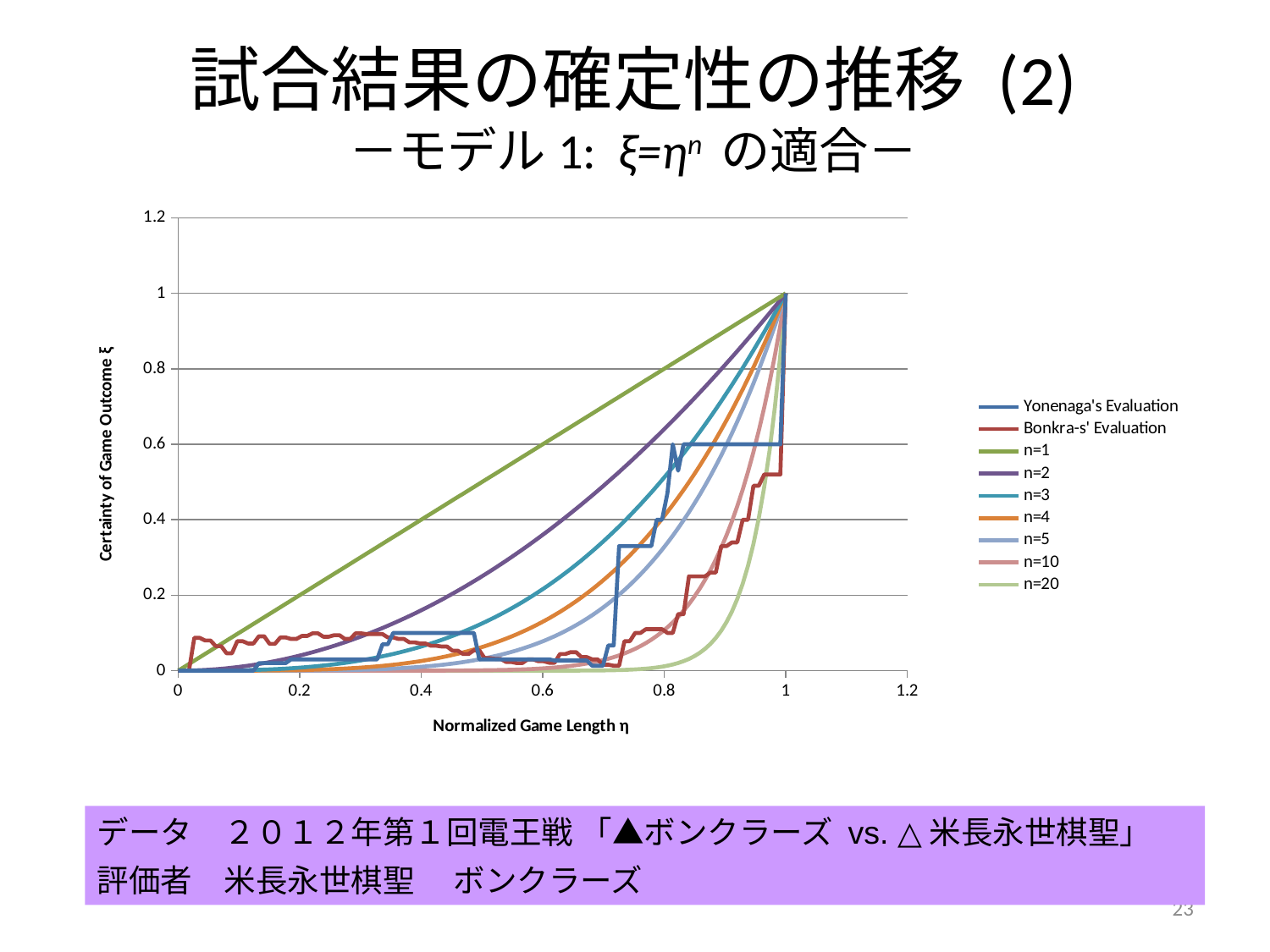
What is the title of the x axis? Normalized Game Length η Does the n=1 curve rise or fall as η increases from 0 to 1? rise Is the value of the n=20 curve at η = 0.8 greater or less than 0.2? less How many series does the legend list? 9 Is the value of Bonkra-s' Evaluation at η = 0.9 greater or less than 0.4? less Which series is the highest at η = 0.4? n=1 At η = 0.6, which is larger, the n=1 curve or the n=20 curve? n=1 What kind of chart is shown on the slide? line chart What value do the model curves n=1 through n=20 all reach at η = 1? 1 What is the title of the y axis? Certainty of Game Outcome ξ Is the value of the n=2 curve at η = 0.6 greater or less than 0.4? less Which series is the lowest at η = 0.8? n=20